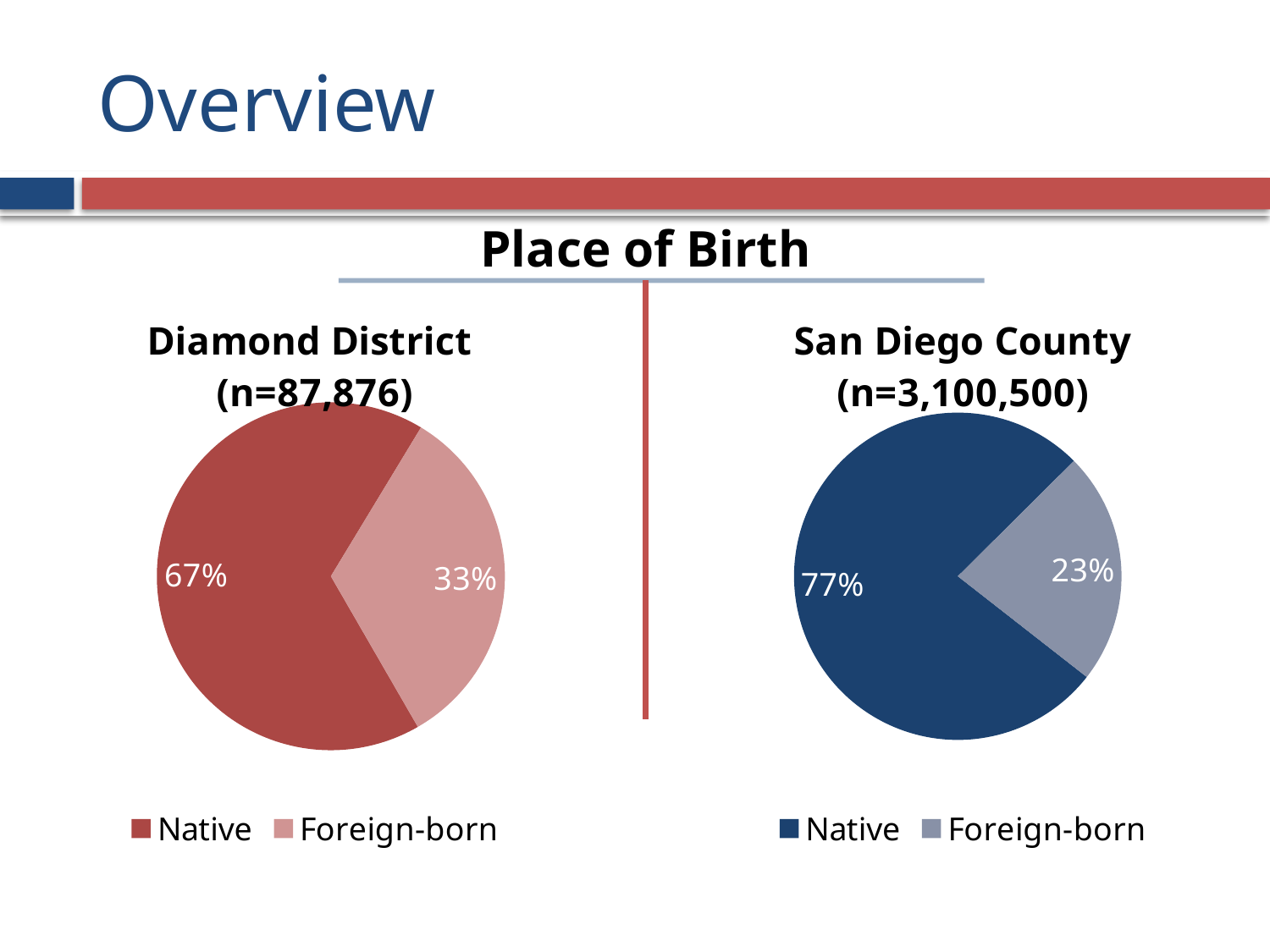
In the San Diego County pie chart, which slice is the smallest? Foreign-born In the Diamond District pie chart, what share is Foreign-born? 33% In the San Diego County pie chart, what share is Native? 77% In the San Diego County pie chart, what share is Foreign-born? 23% Which is larger: the Foreign-born share in the Diamond District chart or the Foreign-born share in the San Diego County chart? Diamond District In the Diamond District pie chart, which slice is the largest? Native In the Diamond District pie chart, what is the difference between the Native and Foreign-born shares? 34% How many slices does the San Diego County pie chart have? 2 What kind of chart is the Diamond District chart? Pie chart What is the sample size (n) shown for the San Diego County chart? 3,100,500 What is the overall title above the two pie charts? Place of Birth In the Diamond District pie chart, what share is Native? 67%